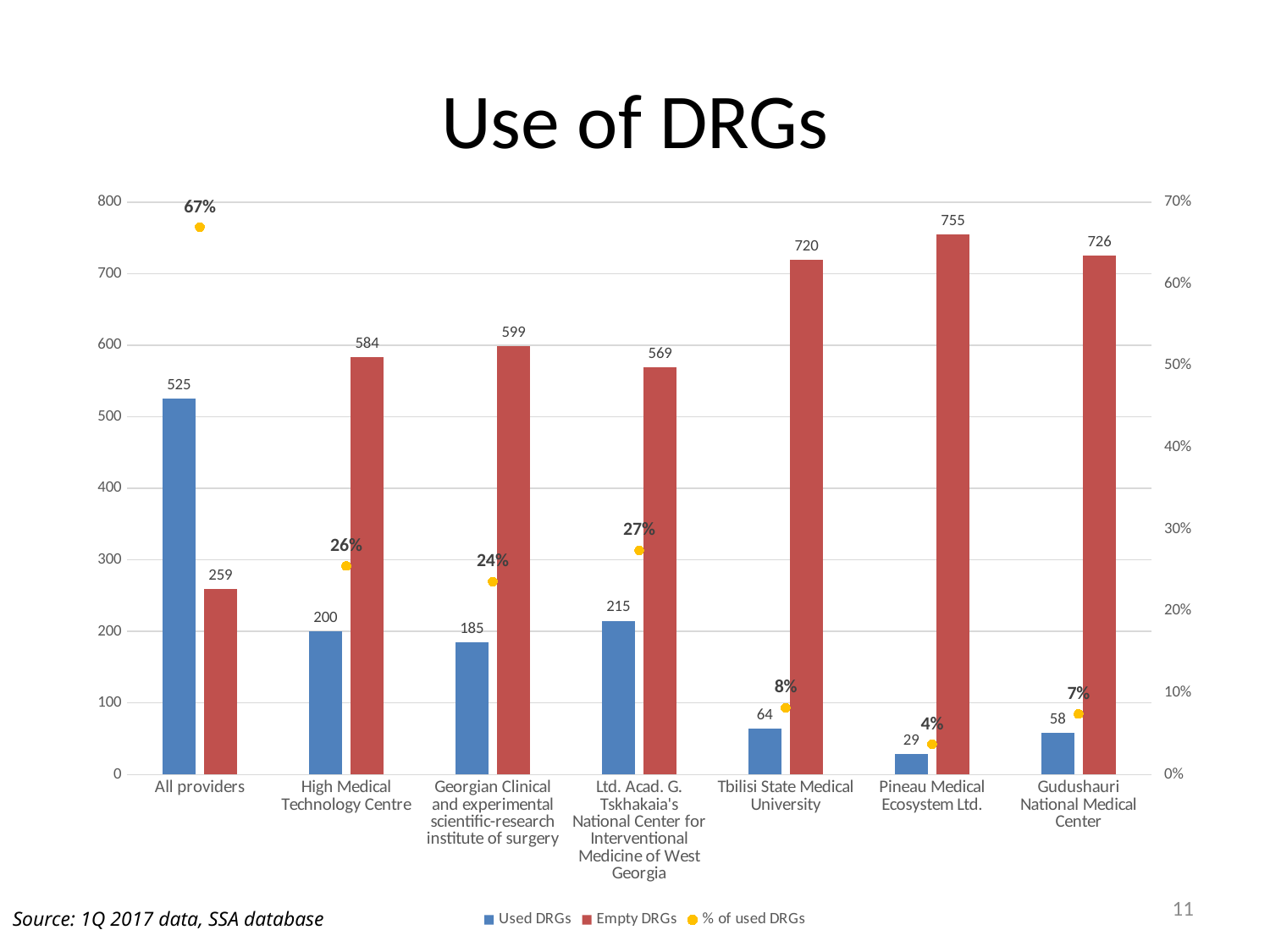
What is the total of Used DRGs and Empty DRGs for Ltd. Acad. G. Tskhakaia's National Center for Interventional Medicine of West Georgia? 784 What is the difference between Empty DRGs and Used DRGs for Gudushauri National Medical Center? 668 Which is larger for All providers: Used DRGs or Empty DRGs? Used DRGs Which category has the lowest number of Used DRGs? Pineau Medical Ecosystem Ltd. What kind of chart is used for the Used DRGs and Empty DRGs series? Bar chart What is the title of the chart? Use of DRGs What is the % of used DRGs for Tbilisi State Medical University? 8% Which category has the highest number of Empty DRGs? Pineau Medical Ecosystem Ltd. How many series does the legend list? 3 How many provider categories are shown on the x axis? 7 What is the number of Empty DRGs for Pineau Medical Ecosystem Ltd.? 755 What is the number of Used DRGs for High Medical Technology Centre? 200